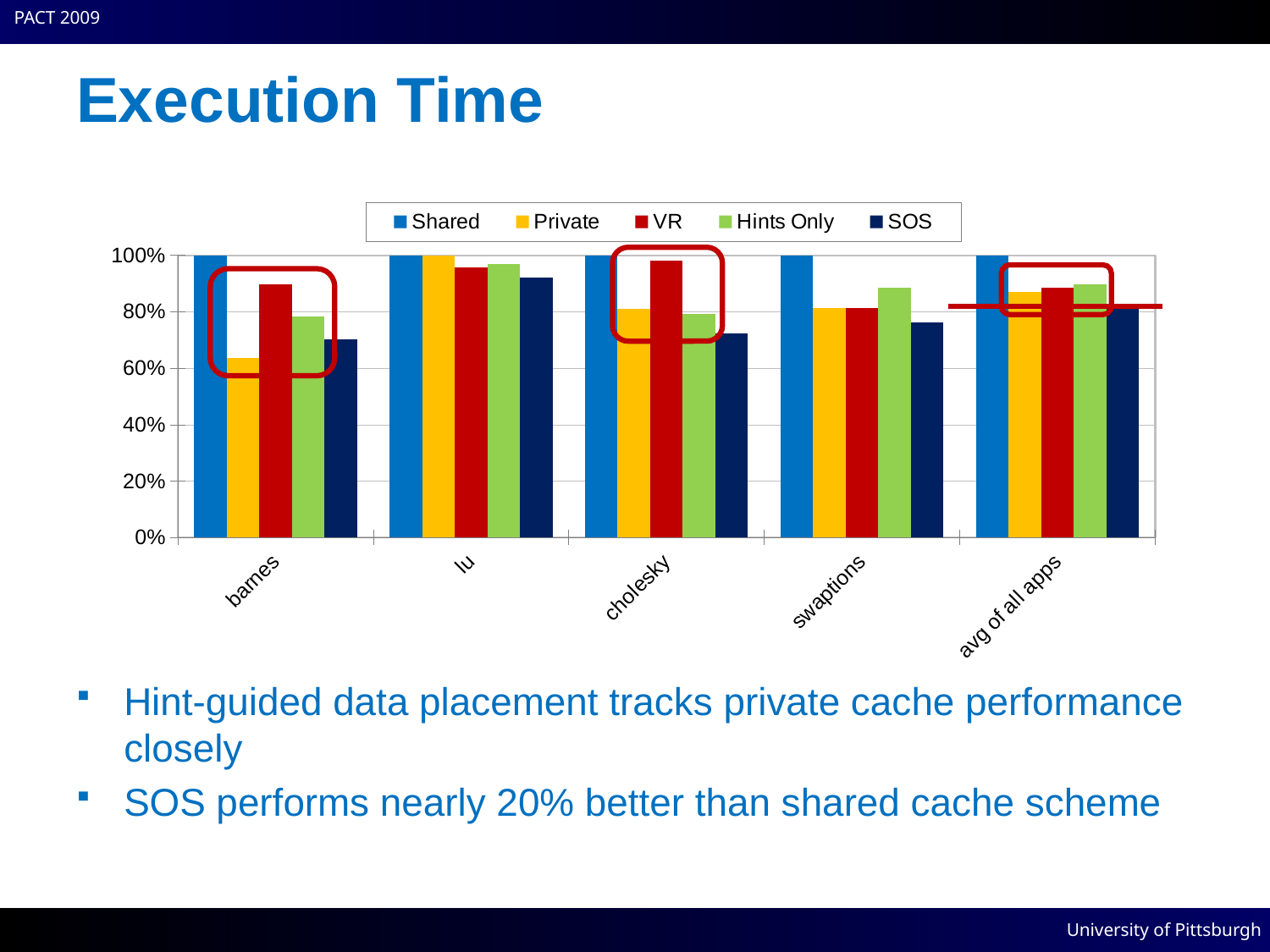
What kind of chart is shown on the slide? bar chart Which series has the lowest value for cholesky? SOS How many categories are shown along the x axis of the chart? 5 How many series does the chart legend list? 5 Is the value of the SOS series for swaptions greater or less than 80%? less What is the value of the Shared series for barnes? 100% For barnes, which is larger: the VR value or the Hints Only value? VR What is the title of the chart on the slide? Execution Time Is the value of the Private series for barnes greater or less than 80%? less Is the value of the VR series for cholesky greater or less than 80%? greater Which series has the lowest value for barnes? Private